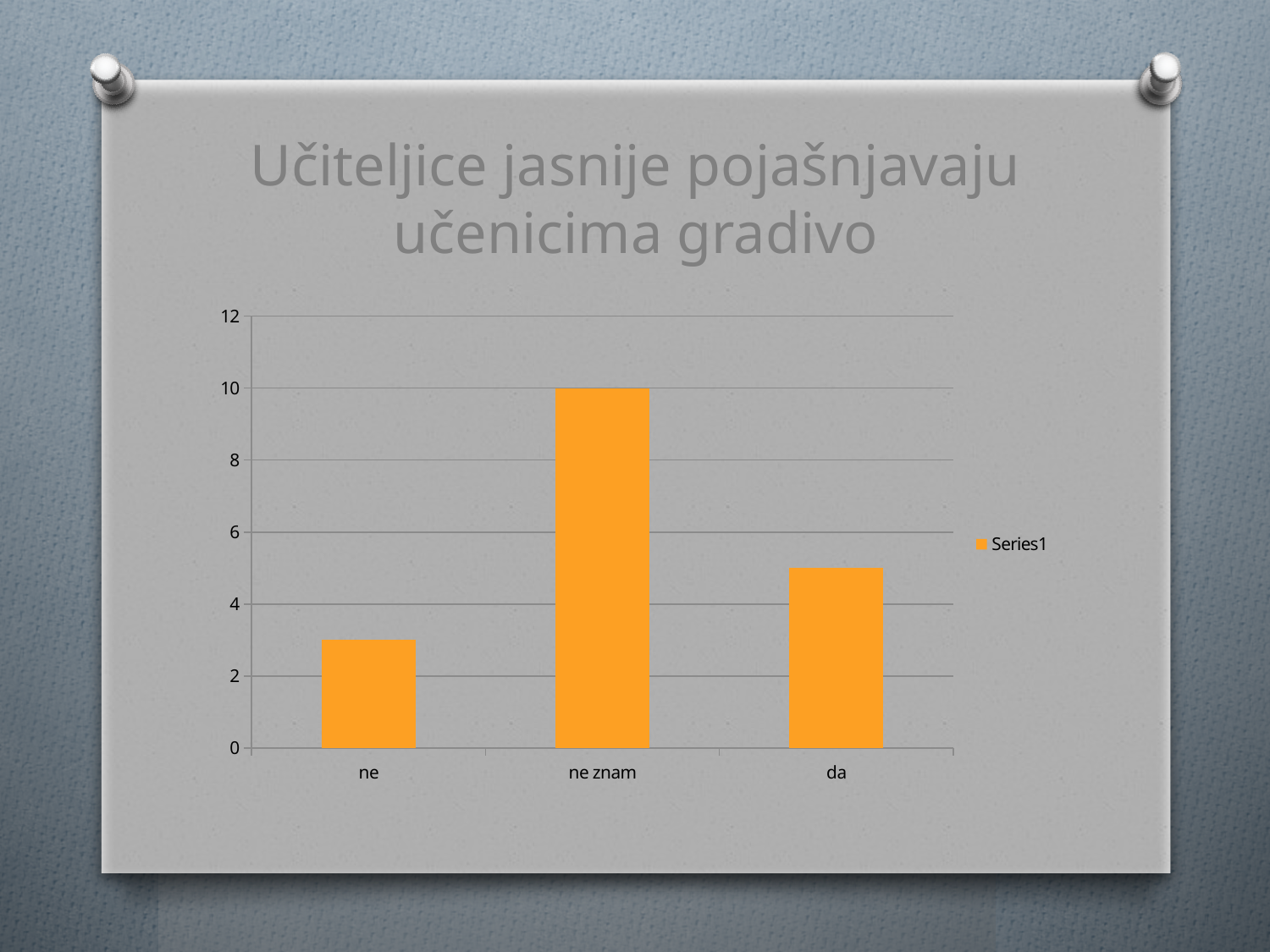
How many categories are shown on the x axis? 3 Is the value for "da" greater or less than 4? greater Is the value for "ne" greater or less than 4? less How many series does the legend list? 1 Is the value for "da" greater or less than 6? less What is the value for "ne znam"? 10 Which category has the lowest value? ne What kind of chart is shown on the slide? bar chart Which is larger, the value for "da" or the value for "ne"? da What is the name of the series shown in the legend? Series1 Which category has the highest value? ne znam